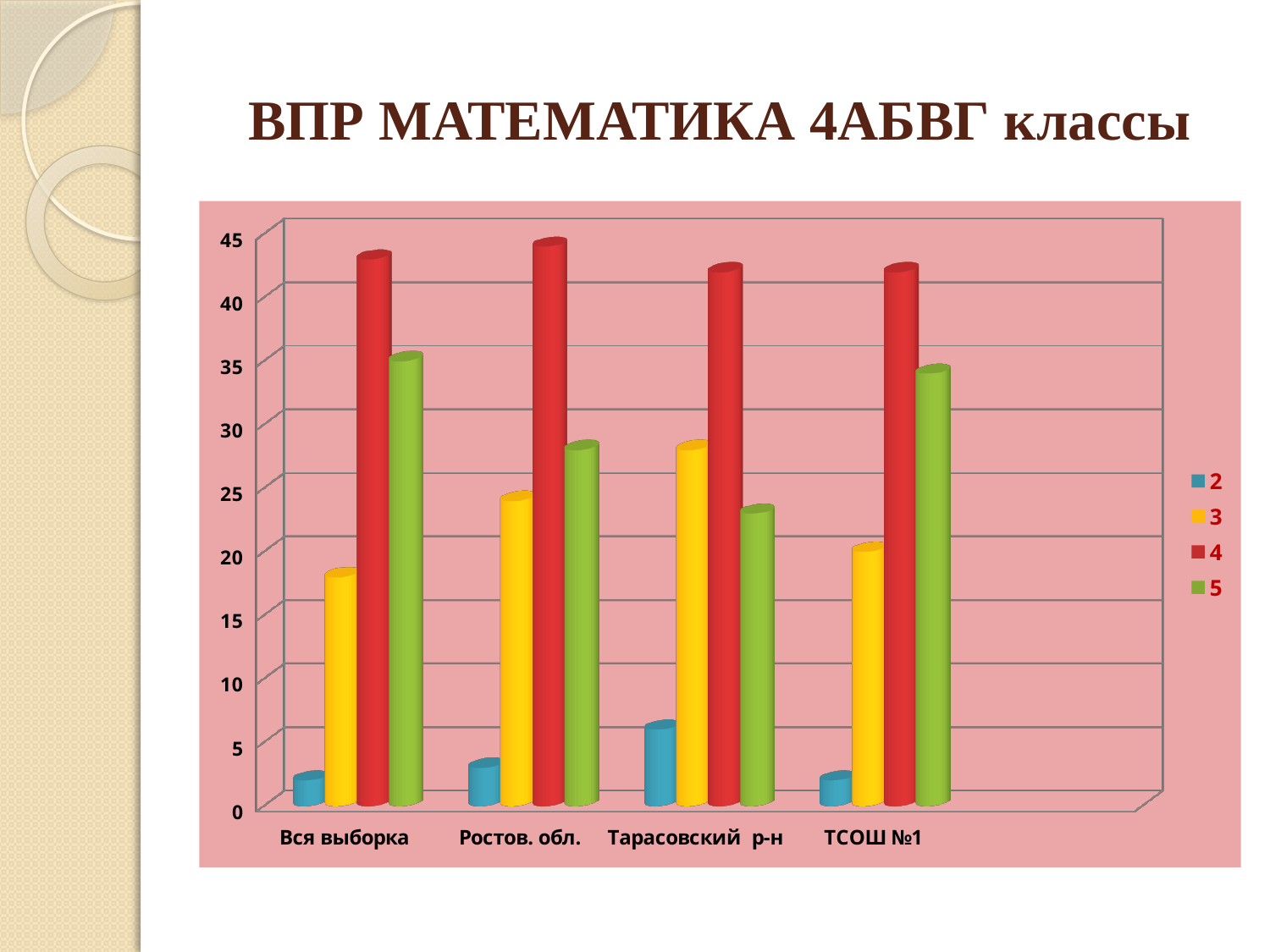
For series 3, which is larger: the value for 'Тарасовский р-н' or for 'Вся выборка'? Тарасовский р-н How many categories are shown on the x axis of the chart? 4 Is the value of series 4 for 'Вся выборка' greater or less than 40? greater For series 5, which is larger: the value for 'Вся выборка' or for 'Ростов. обл.'? Вся выборка Is the value of series 3 for 'Вся выборка' greater or less than 20? less Which series has the lowest bar in the 'Тарасовский р-н' category? 2 Is the value of series 5 for 'ТСОШ №1' greater or less than 30? greater Which series has the highest bar in the 'Вся выборка' category? 4 How many series does the legend list? 4 What is the title of the chart on the slide? ВПР МАТЕМАТИКА 4АБВГ классы What type of chart is shown on the slide? bar chart